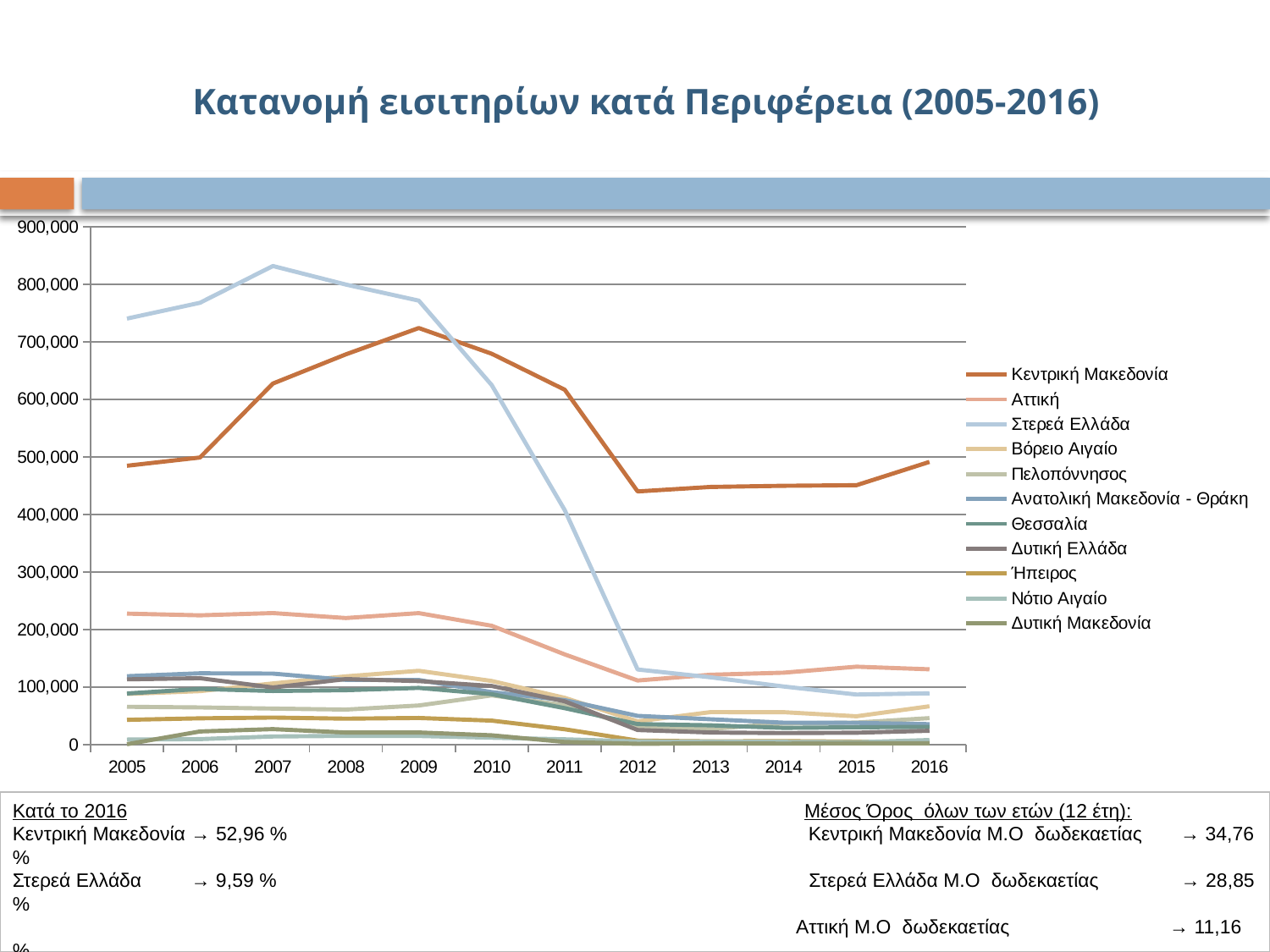
What kind of chart is shown on the slide? line chart Does the value for Στερεά Ελλάδα rise or fall between 2009 and 2012? fall Is the value for Αττική in 2005 greater or less than 200,000? greater Is the value for Κεντρική Μακεδονία in 2012 greater or less than 500,000? less What is the title of the chart? Κατανομή εισιτηρίων κατά Περιφέρεια (2005-2016) Is the value for Στερεά Ελλάδα in 2012 greater or less than 200,000? less How many series does the legend list? 11 Which region has the highest value in 2016? Κεντρική Μακεδονία How many years are shown along the x axis? 12 In 2005, which is larger: the value for Στερεά Ελλάδα or the value for Κεντρική Μακεδονία? Στερεά Ελλάδα Which region has the highest value in 2007? Στερεά Ελλάδα